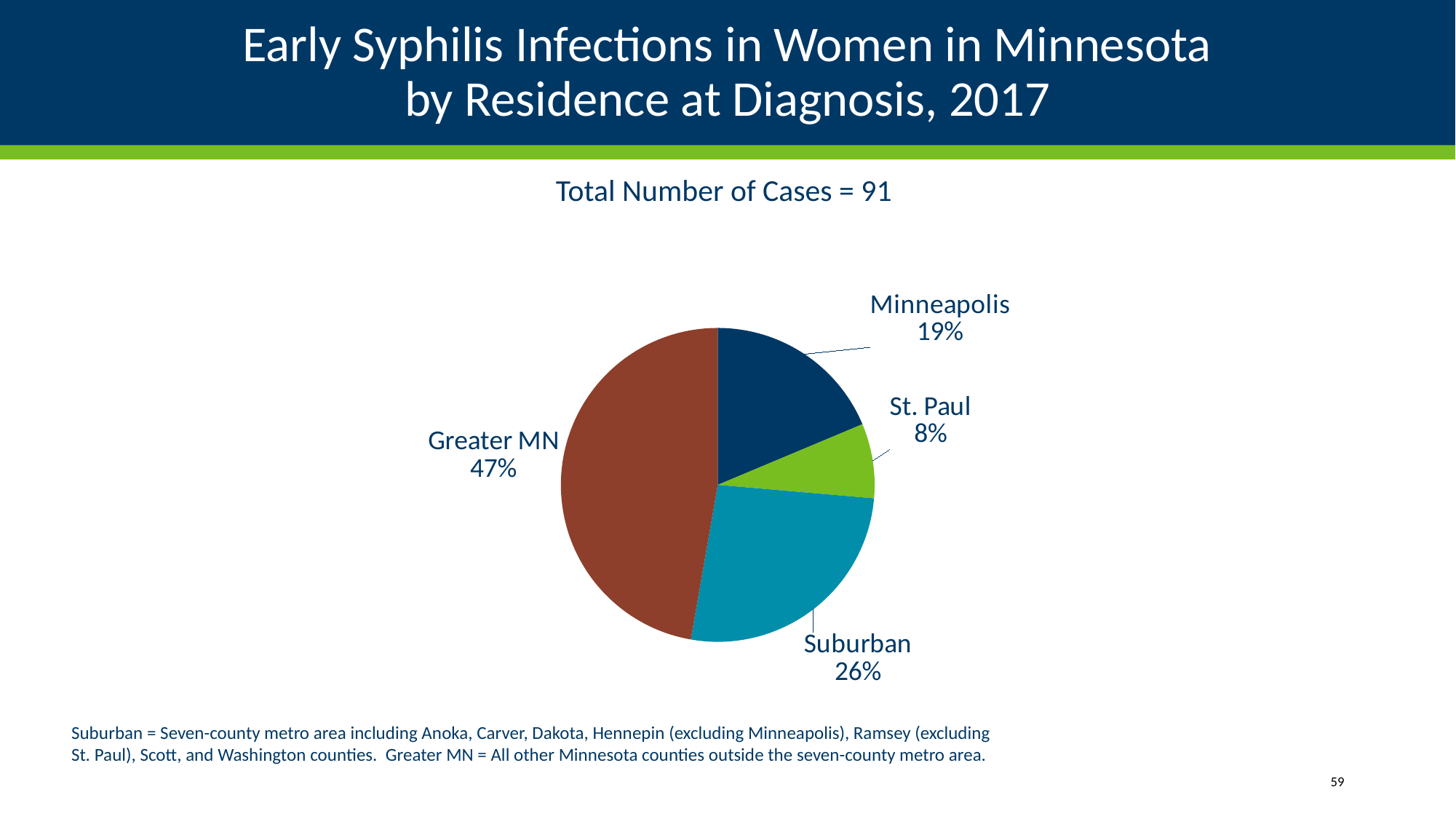
What is the difference in percentage points between the Greater MN and Suburban shares? 21 What percentage of cases is shown for Minneapolis? 19% What is the total number of cases stated on the slide? 91 What share of early syphilis infections in women is attributed to Greater MN? 47% What type of chart is shown on the slide? Pie chart Which residence category has the largest share of cases? Greater MN Which has a larger share of cases, Suburban or Minneapolis? Suburban What is the difference in percentage points between the Minneapolis and St. Paul shares? 11 What percentage of cases is shown for St. Paul? 8% What percentage of cases is shown for Suburban? 26% How many residence categories are shown in the pie chart? 4 Which residence category has the smallest share of cases? St. Paul